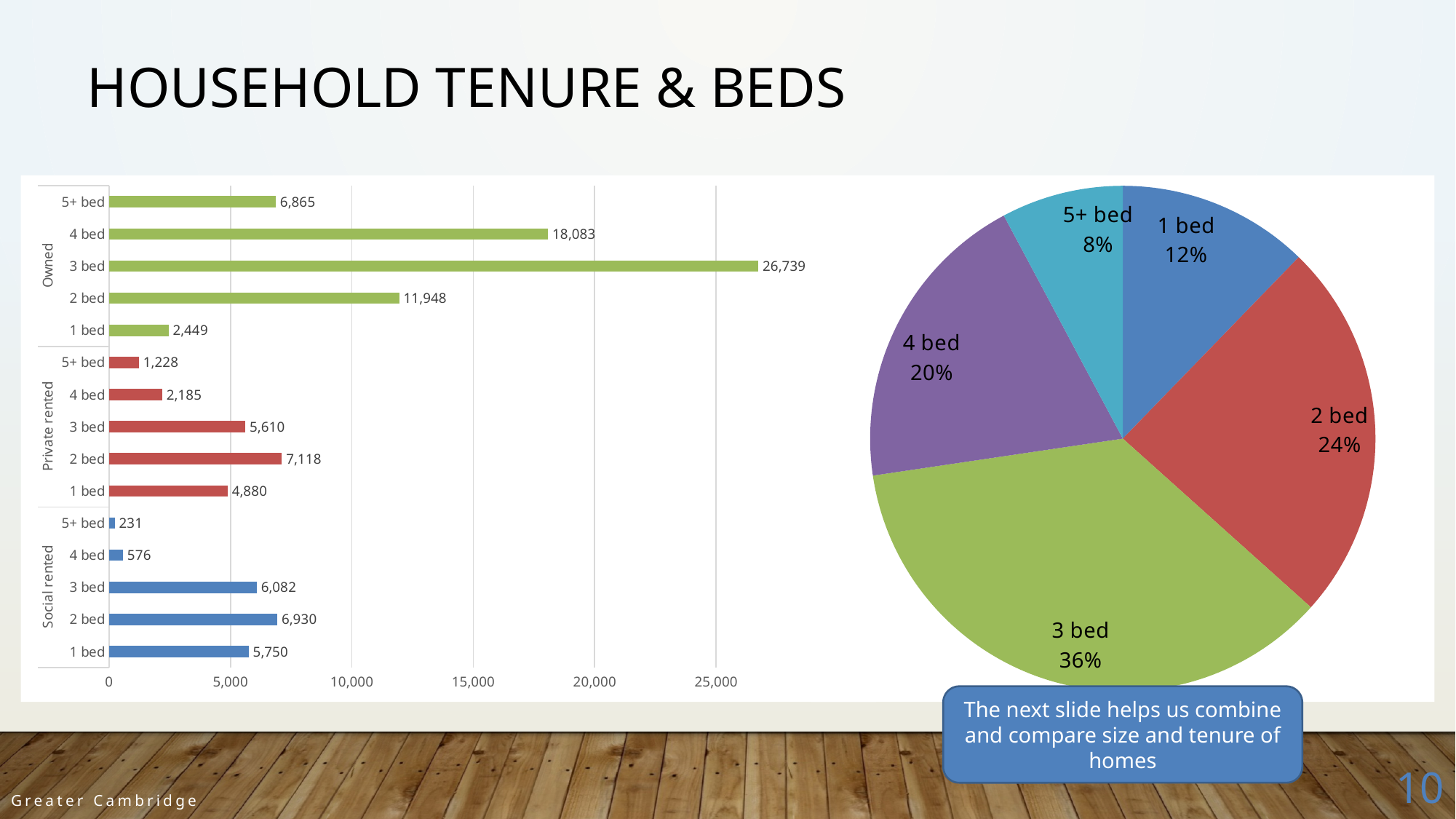
In the bar chart on the left, what is the value for 5+ bed homes in the Social rented group? 231 In the bar chart on the left, how many bars are plotted in total? 15 What type of chart is shown on the left of the slide? Bar chart In the bar chart on the left, which category has the highest value overall? 3 bed (Owned) In the bar chart on the left, what is the value for 2 bed homes in the Private rented group? 7,118 In the pie chart on the right, what share do 3 bed homes have? 36% In the bar chart on the left, what is the value for 3 bed homes in the Owned group? 26,739 In the bar chart on the left, which is larger: 1 bed Private rented or 1 bed Social rented? 1 bed Social rented In the pie chart on the right, which slice is the smallest? 5+ bed In the bar chart on the left, which category in the Social rented group has the lowest value? 5+ bed In the pie chart on the right, how many slices are there? 5 In the bar chart on the left, what is the difference between 4 bed Owned and 2 bed Owned homes? 6,135